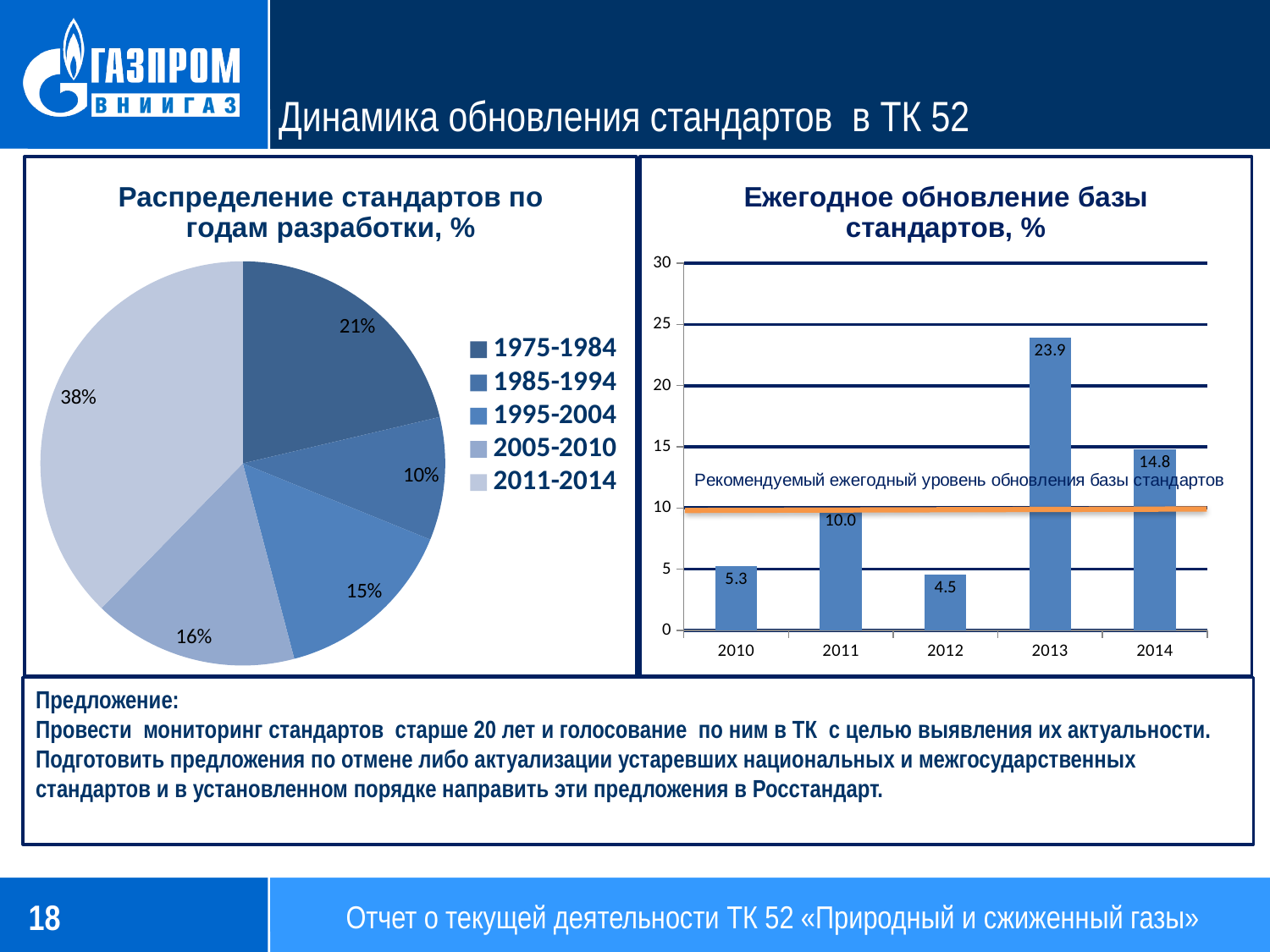
In the bar chart 'Ежегодное обновление базы стандартов, %', what is the value for 2013? 23.9 In the bar chart 'Ежегодное обновление базы стандартов, %', which year has the highest value? 2013 In the bar chart 'Ежегодное обновление базы стандартов, %', what does the orange horizontal line represent? Рекомендуемый ежегодный уровень обновления базы стандартов How many entries does the legend of the pie chart 'Распределение стандартов по годам разработки, %' list? 5 What type of chart is the chart on the right side of the slide? Bar chart In the bar chart 'Ежегодное обновление базы стандартов, %', how many years are shown on the x axis? 5 In the pie chart 'Распределение стандартов по годам разработки, %', what share does the 2011-2014 slice have? 38% In the bar chart 'Ежегодное обновление базы стандартов, %', what is the difference between the values for 2013 and 2014? 9.1 In the pie chart 'Распределение стандартов по годам разработки, %', which period has the smallest slice? 1985-1994 In the bar chart 'Ежегодное обновление базы стандартов, %', which year has the lowest value? 2012 In the bar chart 'Ежегодное обновление базы стандартов, %', what is the value for 2010? 5.3 In the bar chart 'Ежегодное обновление базы стандартов, %', is the value for 2011 or 2014 larger? 2014